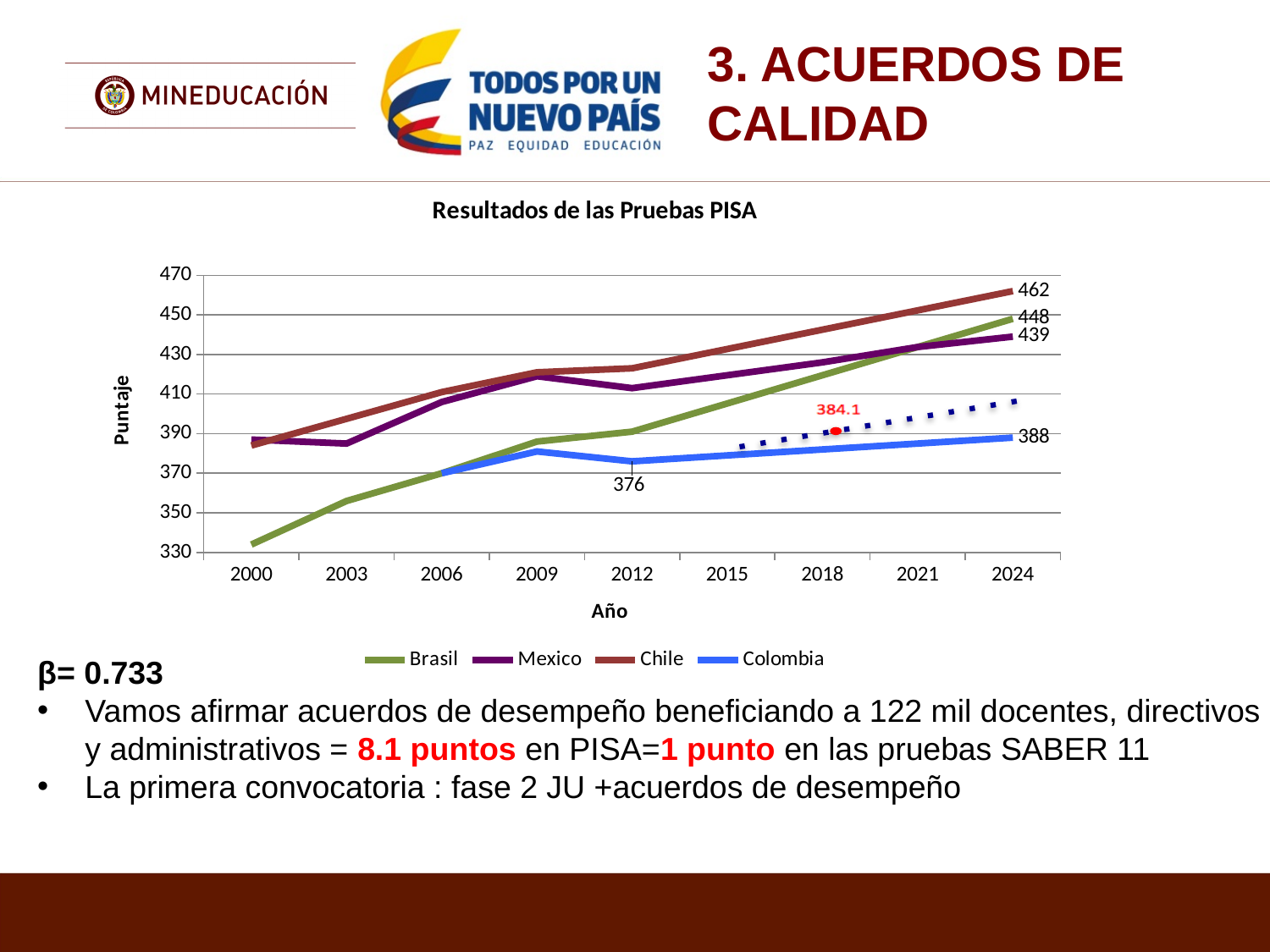
What kind of chart is shown on the slide? Line chart Which country has the highest value in 2024? Chile By how much does Colombia's value increase from 2012 to 2024? 12 What is the value for Brasil in 2024? 448 What is the value for Chile in 2024? 462 What is the difference between Chile's and Colombia's values in 2024? 74 Is the value for Brasil in 2000 greater or less than 350? less How many series does the legend list? 4 What is the value for Mexico in 2024? 439 Which is larger in 2024, the value for Brasil or the value for Mexico? Brasil What is the value for Colombia in 2012? 376 Which country has the lowest value in 2024? Colombia